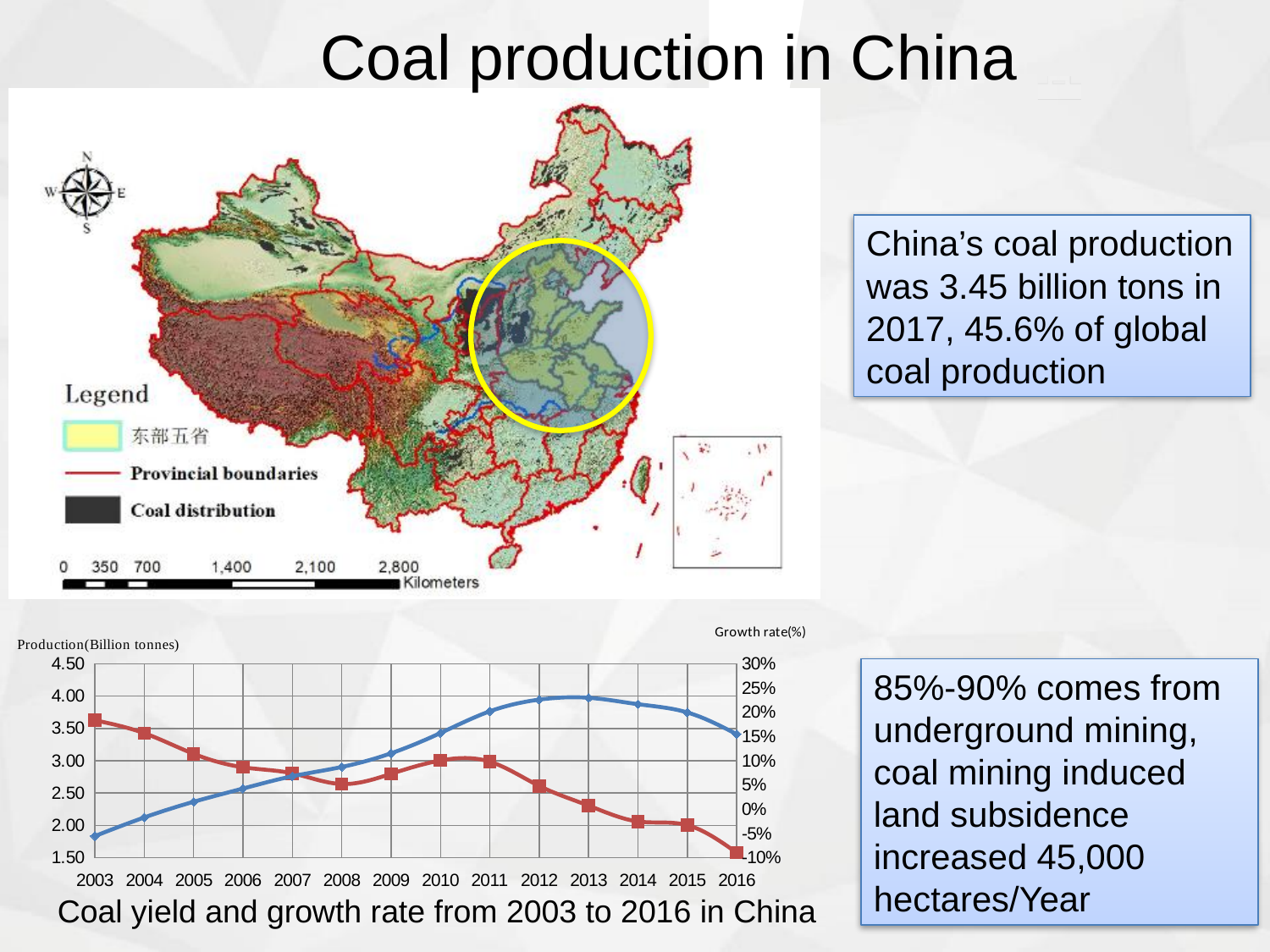
How many data series are plotted in the coal yield and growth rate chart? 2 What is the title of the left vertical axis of the coal yield and growth rate chart? Production(Billion tonnes) In the coal yield and growth rate chart, which year has the lowest production? 2003 What kind of chart is shown at the bottom of the slide? line chart What is the caption of the chart at the bottom of the slide? Coal yield and growth rate from 2003 to 2016 in China How many years are plotted along the x axis of the coal yield and growth rate chart? 14 In the coal yield and growth rate chart, which year has the highest growth rate? 2003 In the coal yield and growth rate chart, is the production value for 2003 greater or less than 2.00 billion tonnes? less In the coal yield and growth rate chart, does the growth rate line generally rise or fall from 2003 to 2016? fall In the coal yield and growth rate chart, is the growth rate for 2016 greater or less than 0%? less In the coal yield and growth rate chart, is production higher in 2003 or in 2016? 2016 In the coal yield and growth rate chart, which year has the lowest growth rate? 2016